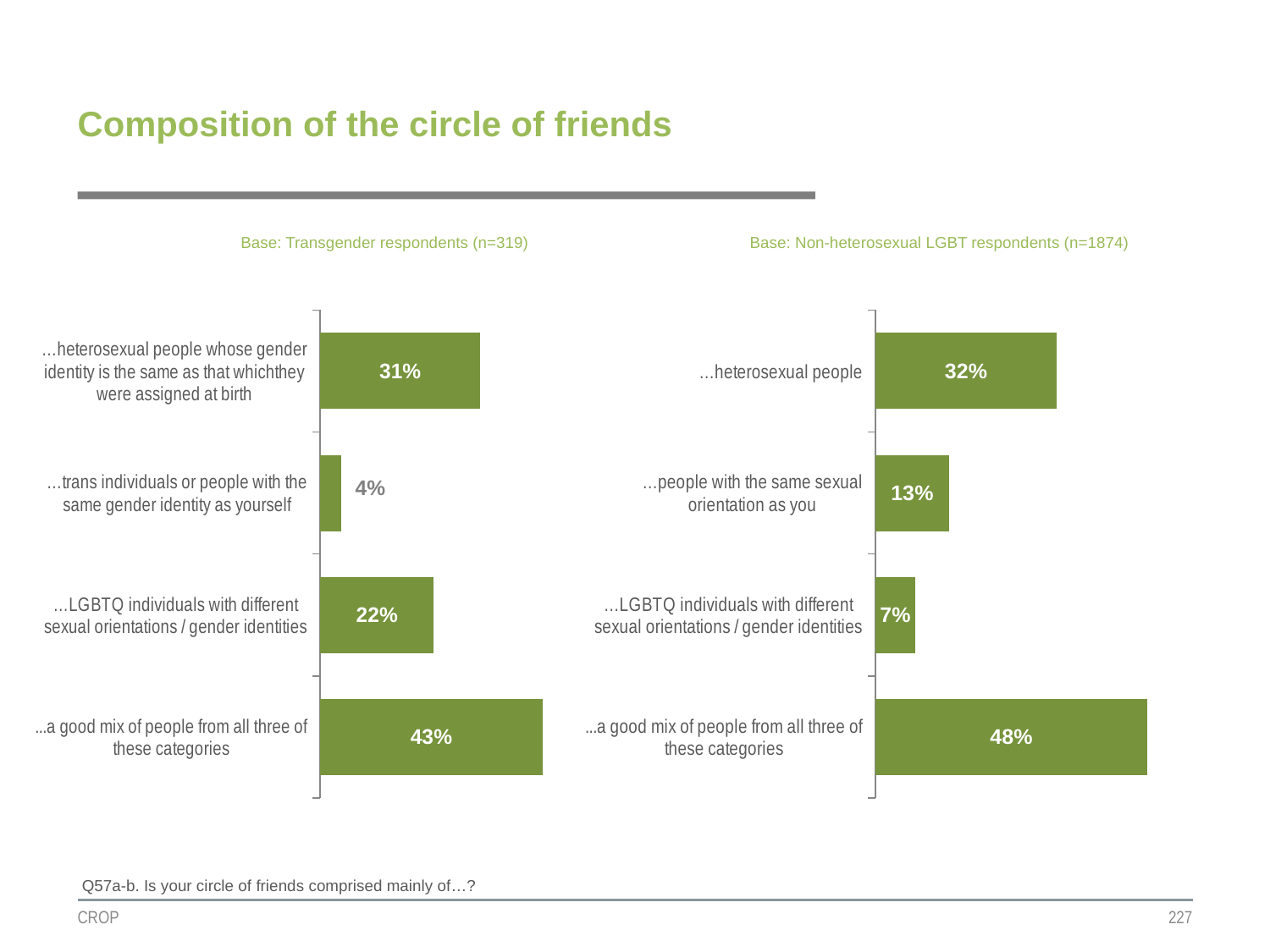
In the right chart (Non-heterosexual LGBT respondents), which category has the lowest percentage? …LGBTQ individuals with different sexual orientations / gender identities Which is larger: the percentage for a good mix of people from all three categories in the left chart (Transgender respondents) or in the right chart (Non-heterosexual LGBT respondents)? Right chart (Non-heterosexual LGBT respondents), 48% What is the sample size (n) stated for the left chart's base of Transgender respondents? 319 In the right chart (Non-heterosexual LGBT respondents), what is the difference between the percentage for heterosexual people and the percentage for people with the same sexual orientation as you? 19 percentage points In the left chart (Transgender respondents), which category has the highest percentage? ...a good mix of people from all three of these categories In the right chart (Non-heterosexual LGBT respondents), what percentage say their friends are mainly LGBTQ individuals with different sexual orientations / gender identities? 7% How many categories are shown in the right chart (Non-heterosexual LGBT respondents)? 4 In the left chart (Transgender respondents), what is the difference between the percentage for a good mix of people from all three categories and the percentage for LGBTQ individuals with different sexual orientations / gender identities? 21 percentage points What type of chart is used on this slide? Bar chart In the left chart (Transgender respondents), what percentage of respondents say their circle of friends is mainly a good mix of people from all three categories? 43% In the left chart (Transgender respondents), what percentage say their friends are mainly trans individuals or people with the same gender identity as yourself? 4% In the right chart (Non-heterosexual LGBT respondents), what percentage say their circle of friends is mainly heterosexual people? 32%